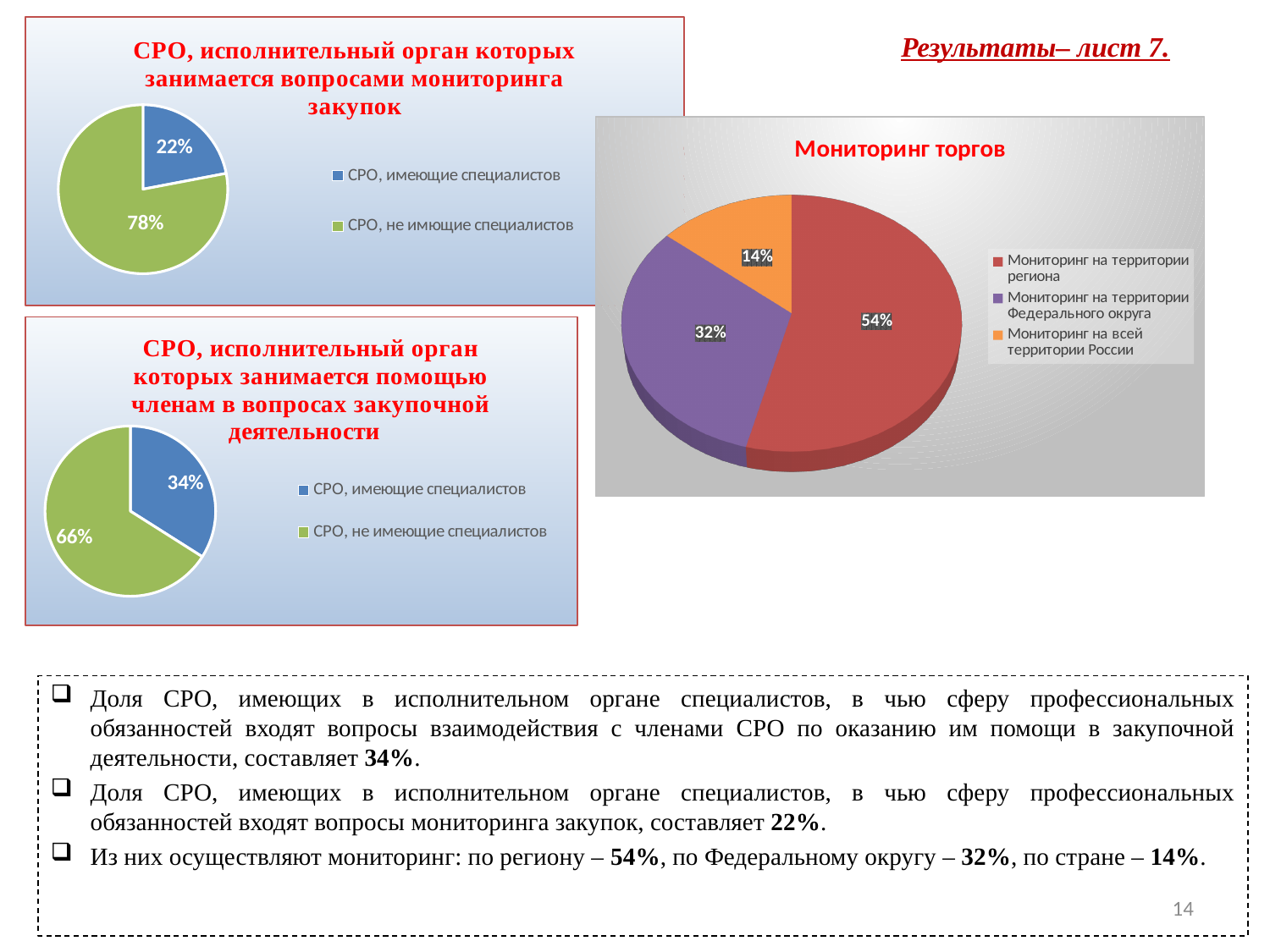
What type of chart is the 'Мониторинг торгов' chart? Pie chart In the 'Мониторинг торгов' chart, which category has the largest share? Мониторинг на территории региона In the bottom-left pie chart (СРО, исполнительный орган которых занимается помощью членам в вопросах закупочной деятельности), what share is shown for 'СРО, не имеющие специалистов'? 66% In the 'Мониторинг торгов' chart, which category has the smallest share? Мониторинг на всей территории России In the top-left pie chart (СРО, исполнительный орган которых занимается вопросами мониторинга закупок), what share is shown for 'СРО, имеющие специалистов'? 22% How many categories does the legend of the 'Мониторинг торгов' chart list? 3 In the bottom-left pie chart (СРО, исполнительный орган которых занимается помощью членам в вопросах закупочной деятельности), what share is shown for 'СРО, имеющие специалистов'? 34% In the 'Мониторинг торгов' chart, what is the difference in percentage points between 'Мониторинг на территории региона' and 'Мониторинг на территории Федерального округа'? 22